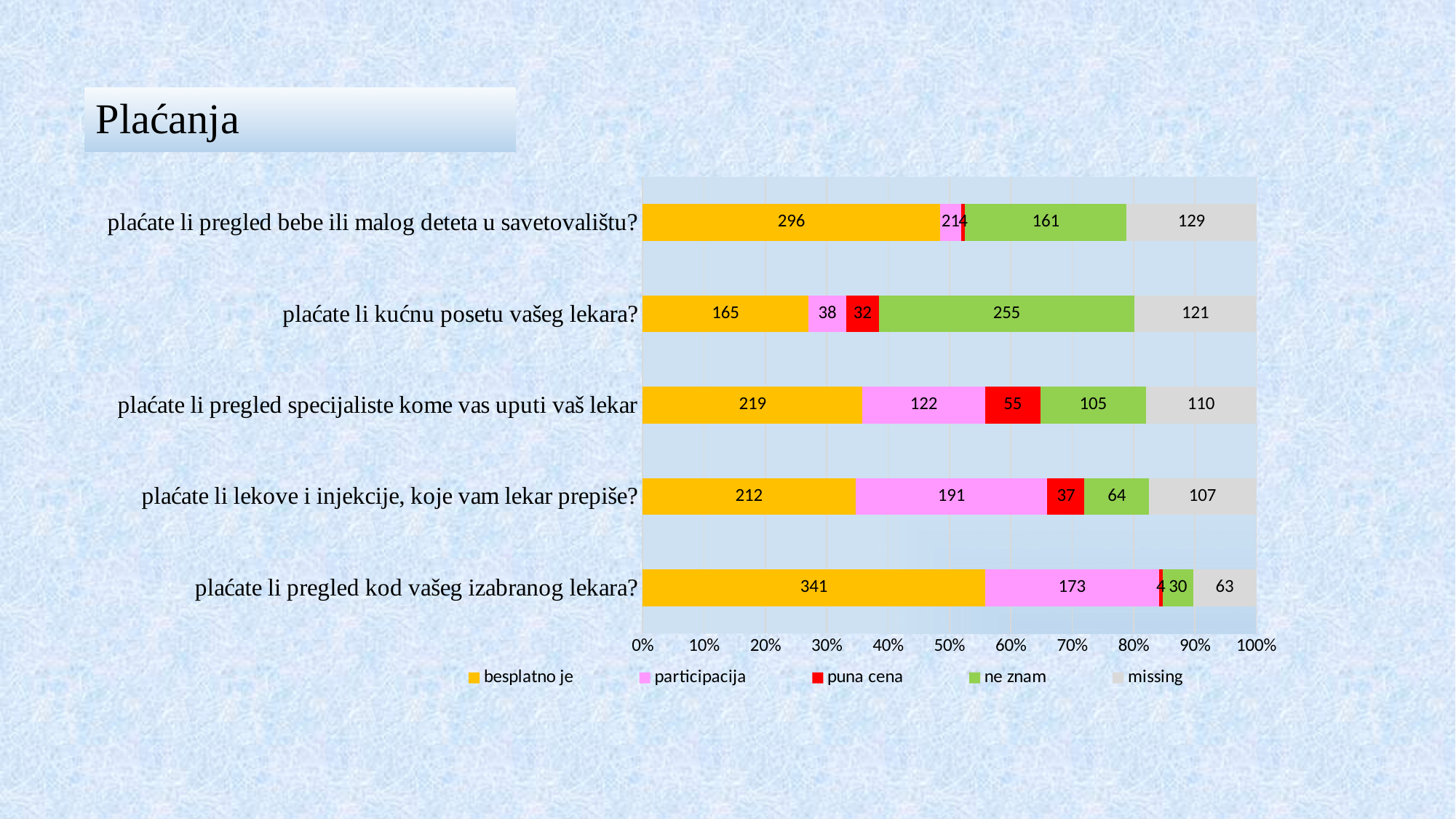
Which category has the lowest 'missing' value? plaćate li pregled kod vašeg izabranog lekara? What is the difference between the 'participacija' values for 'plaćate li lekove i injekcije, koje vam lekar prepiše?' and 'plaćate li pregled specijaliste kome vas uputi vaš lekar'? 69 How many series does the legend list? 5 What kind of chart is shown on the slide? stacked bar chart What is the 'missing' value for 'plaćate li lekove i injekcije, koje vam lekar prepiše?'? 107 What is the total of all segments in the bar for 'plaćate li kućnu posetu vašeg lekara?'? 611 How many categories (questions) are plotted on the chart? 5 What is the 'besplatno je' value for 'plaćate li pregled kod vašeg izabranog lekara?'? 341 Which category has the highest 'besplatno je' value? plaćate li pregled kod vašeg izabranog lekara? What is the 'ne znam' value for 'plaćate li kućnu posetu vašeg lekara?'? 255 What is the 'puna cena' value for 'plaćate li pregled specijaliste kome vas uputi vaš lekar'? 55 Which is larger: the 'ne znam' value for 'plaćate li kućnu posetu vašeg lekara?' or for 'plaćate li pregled specijaliste kome vas uputi vaš lekar'? plaćate li kućnu posetu vašeg lekara?